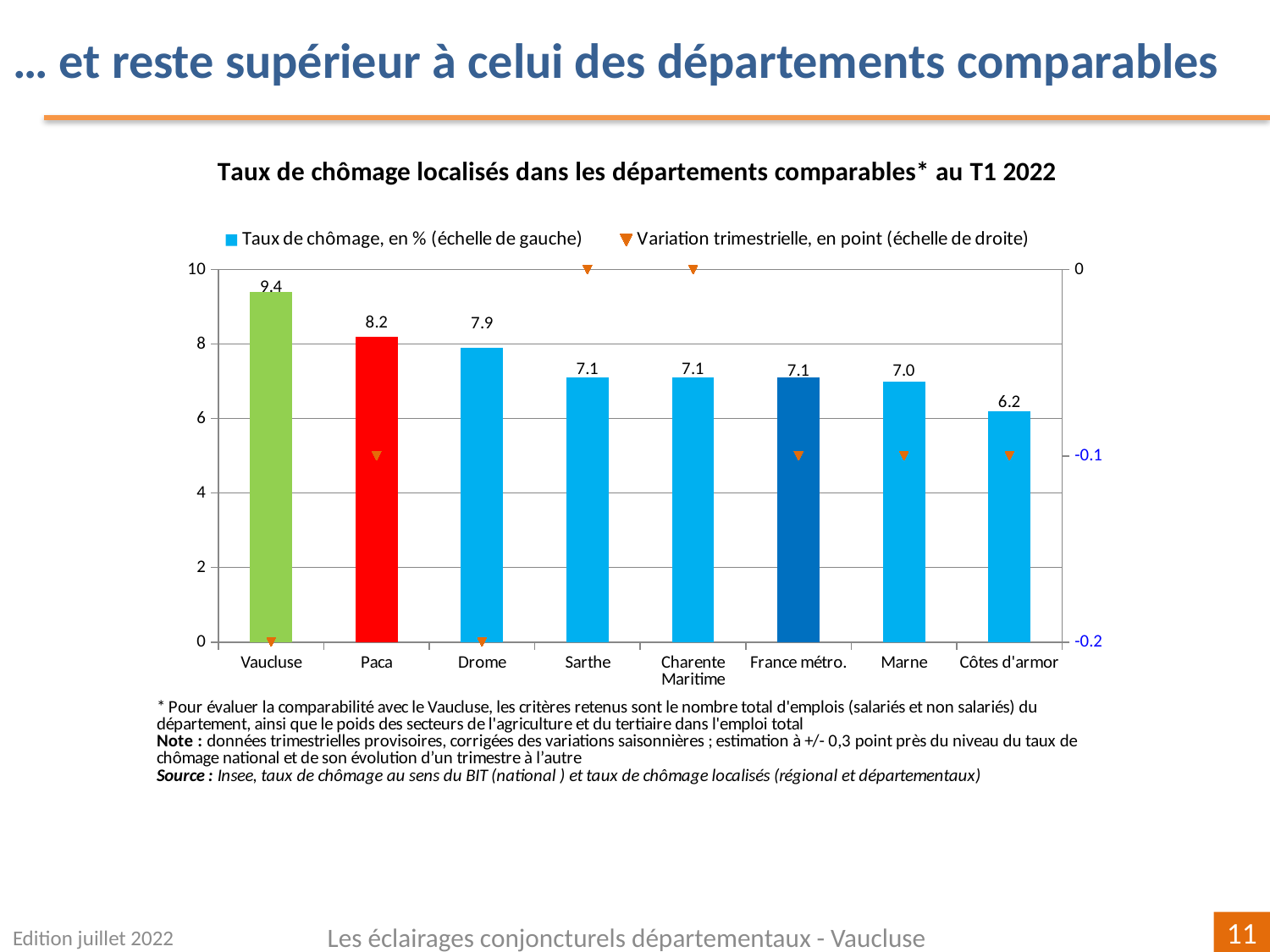
How many categories are shown on the x axis? 8 What is the unemployment rate shown for Côtes d'armor? 6.2 Which category has the highest unemployment rate? Vaucluse What is the unemployment rate shown for Paca? 8.2 What is the quarterly variation (Variation trimestrielle) shown for Sarthe on the right axis? 0 What kind of chart is used to show the unemployment rates? Bar chart How many series does the legend list? 2 What is the quarterly variation shown for Vaucluse on the right axis? -0.2 What is the difference between the unemployment rate of Vaucluse and that of France métro.? 2.3 Which has a higher unemployment rate, Paca or Drome? Paca Which category has the lowest unemployment rate? Côtes d'armor What is the unemployment rate (Taux de chômage) shown for Vaucluse? 9.4